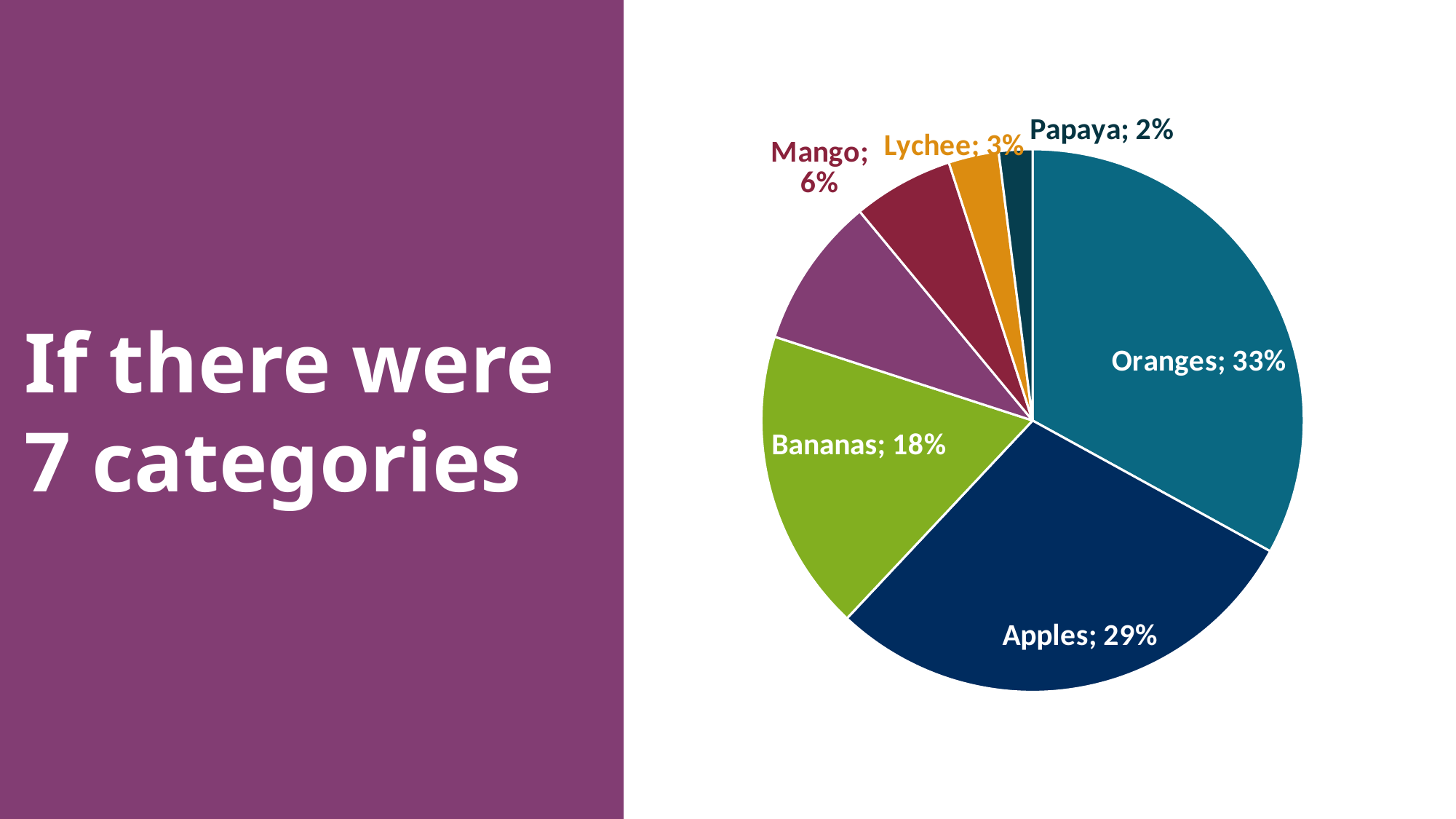
What is the difference between the Oranges and Apples percentages? 4% Which labelled category has the smallest slice of the pie? Papaya What share of the pie do Oranges have? 33% What percentage is shown for Lychee? 3% What is the value shown for Papaya? 2% What is the value shown for Apples? 29% Which is larger, the Bananas slice or the Mango slice? Bananas What percentage is labelled for Bananas? 18% How many slices does the pie chart have? 7 Which category has the largest slice of the pie? Oranges What kind of chart is shown on the slide? pie chart What is the value shown for Mango? 6%